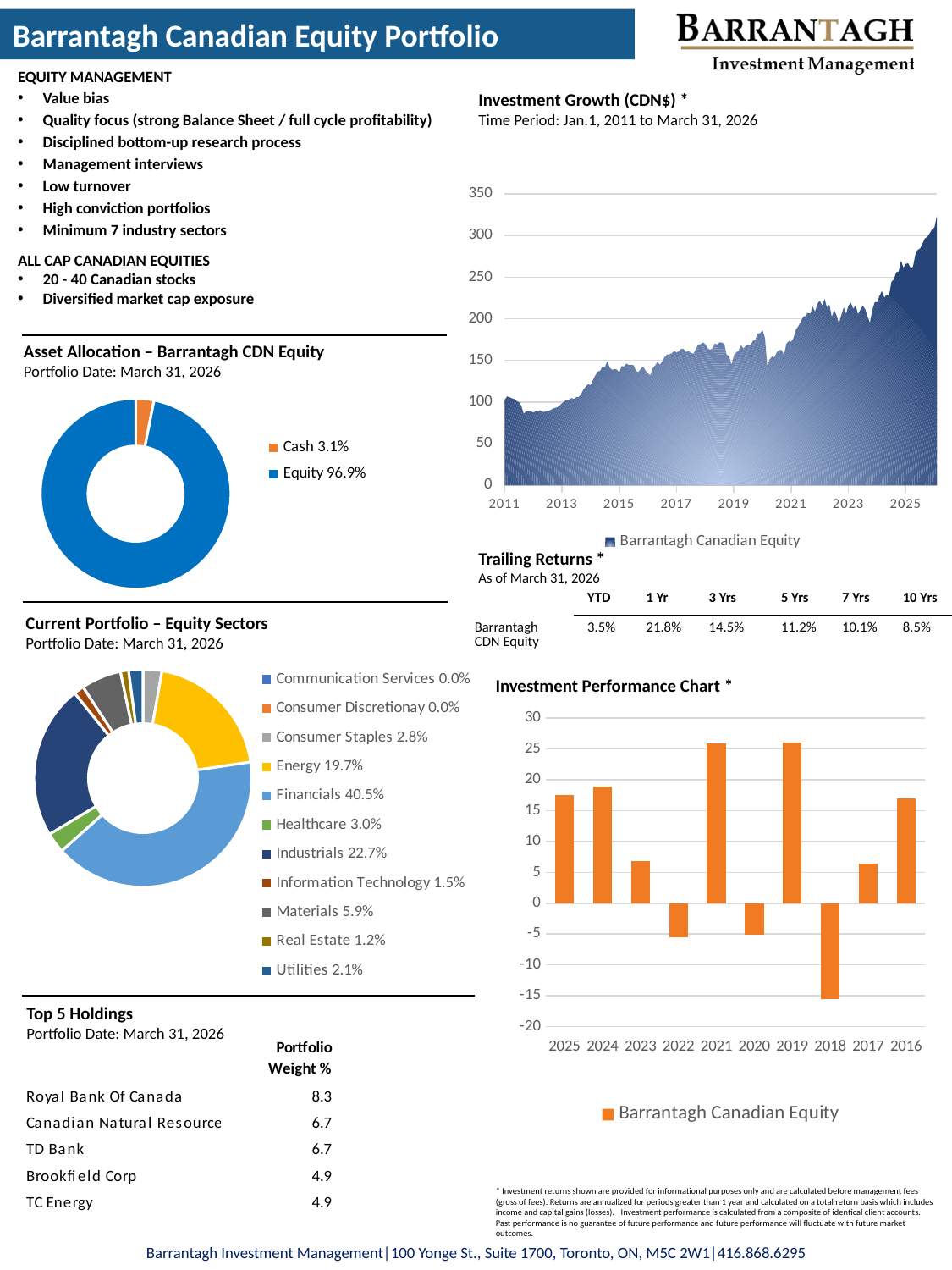
What kind of chart is the Investment Growth (CDN$) chart? Area chart On the Current Portfolio – Equity Sectors chart, what is the difference between the Industrials and Energy shares? 3.0% On the Investment Growth (CDN$) chart, do values generally rise or fall from 2011 to 2026? Rise On the Investment Performance Chart, which year has the lowest value? 2018 On the Investment Performance Chart, is the value for 2021 greater or less than 20? greater On the Current Portfolio – Equity Sectors chart, what is the share for Energy? 19.7% On the Investment Growth (CDN$) chart, is the value at the start of 2025 greater or less than 250? greater On the Current Portfolio – Equity Sectors chart, which sector has the largest share? Financials On the Asset Allocation chart, what percentage is allocated to Cash? 3.1% On the Current Portfolio – Equity Sectors chart, how many sectors are listed in the legend? 11 On the Current Portfolio – Equity Sectors chart, which is larger, Materials or Healthcare? Materials On the Asset Allocation chart, what percentage is allocated to Equity? 96.9%